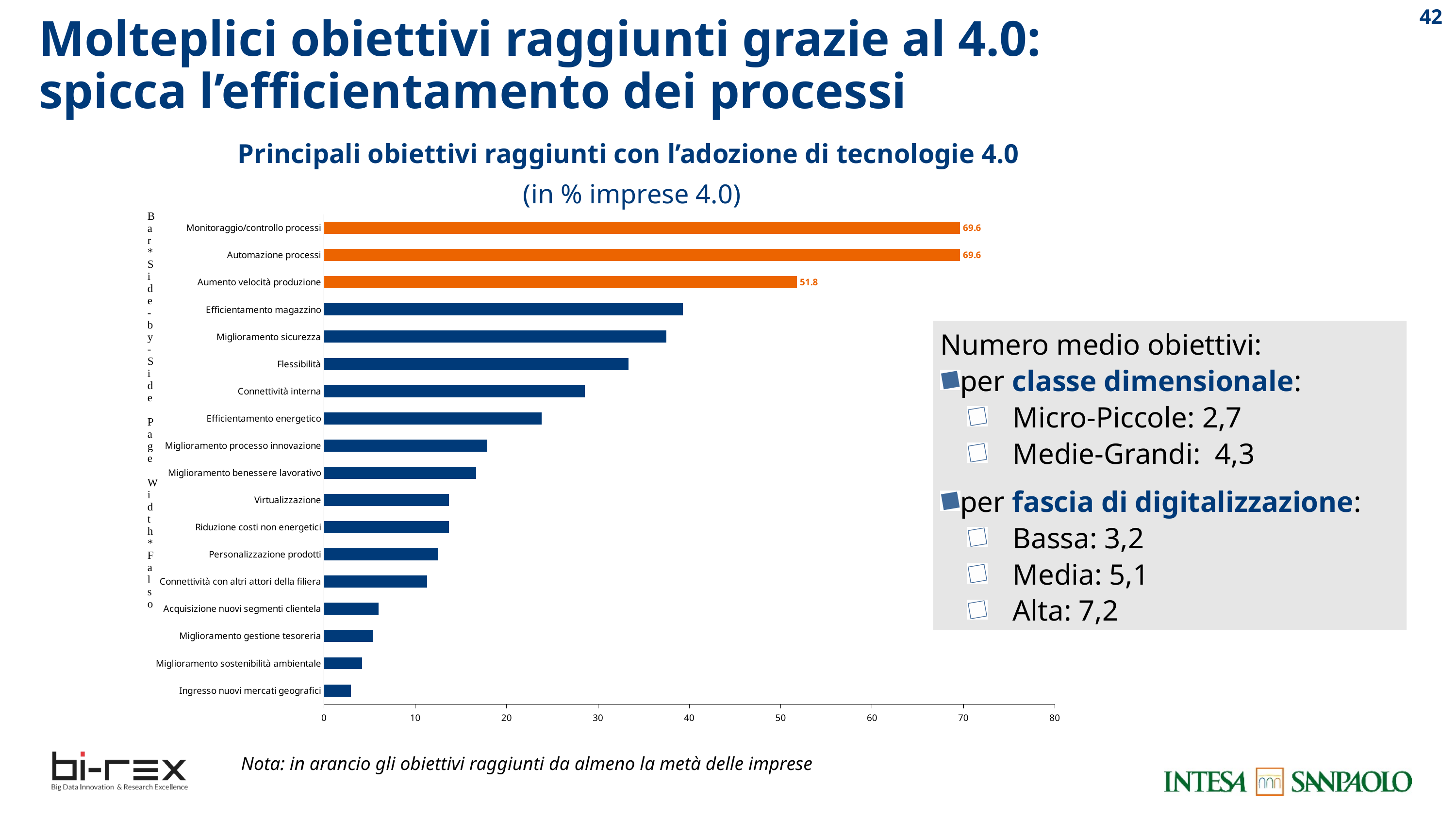
What kind of chart is shown on the slide? bar chart Which category has the lowest value? Ingresso nuovi mercati geografici Is the value for Ingresso nuovi mercati geografici greater or less than 10? less What is the difference between the value for Automazione processi and the value for Aumento velocità produzione? 17.8 Which is larger: the value for Connettività interna or the value for Efficientamento energetico? Connettività interna What is the value for Aumento velocità produzione? 51.8 What is the value for Monitoraggio/controllo processi? 69.6 What is the value for Automazione processi? 69.6 Is the value for Connettività interna greater or less than 30? less How many bars in the chart are coloured orange? 3 Is the value for Efficientamento magazzino greater or less than 30? greater How many categories are shown in the chart? 18